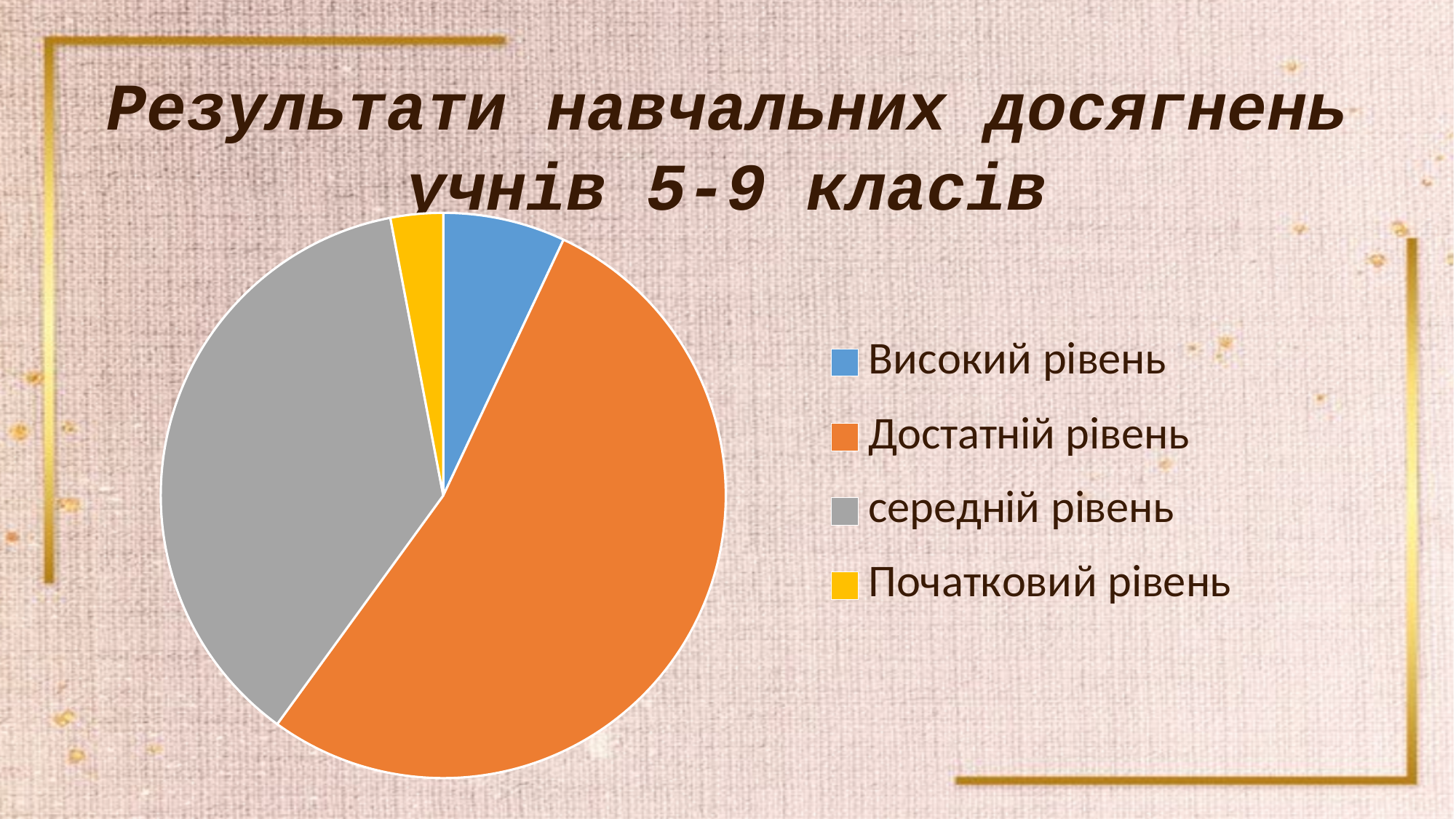
Which category has the largest slice of the pie chart? Достатній рівень How many slices does the pie chart have? 4 What is the title of the slide containing the pie chart? Результати навчальних досягнень учнів 5-9 класів What kind of chart is shown on the slide? Pie chart How many entries does the legend of the pie chart list? 4 Which slice is larger: середній рівень or Високий рівень? середній рівень Which slice is larger: Достатній рівень or середній рівень? Достатній рівень Which slice is larger: Високий рівень or Початковий рівень? Високий рівень What colour represents Достатній рівень in the pie chart? Orange Which category has the smallest slice of the pie chart? Початковий рівень